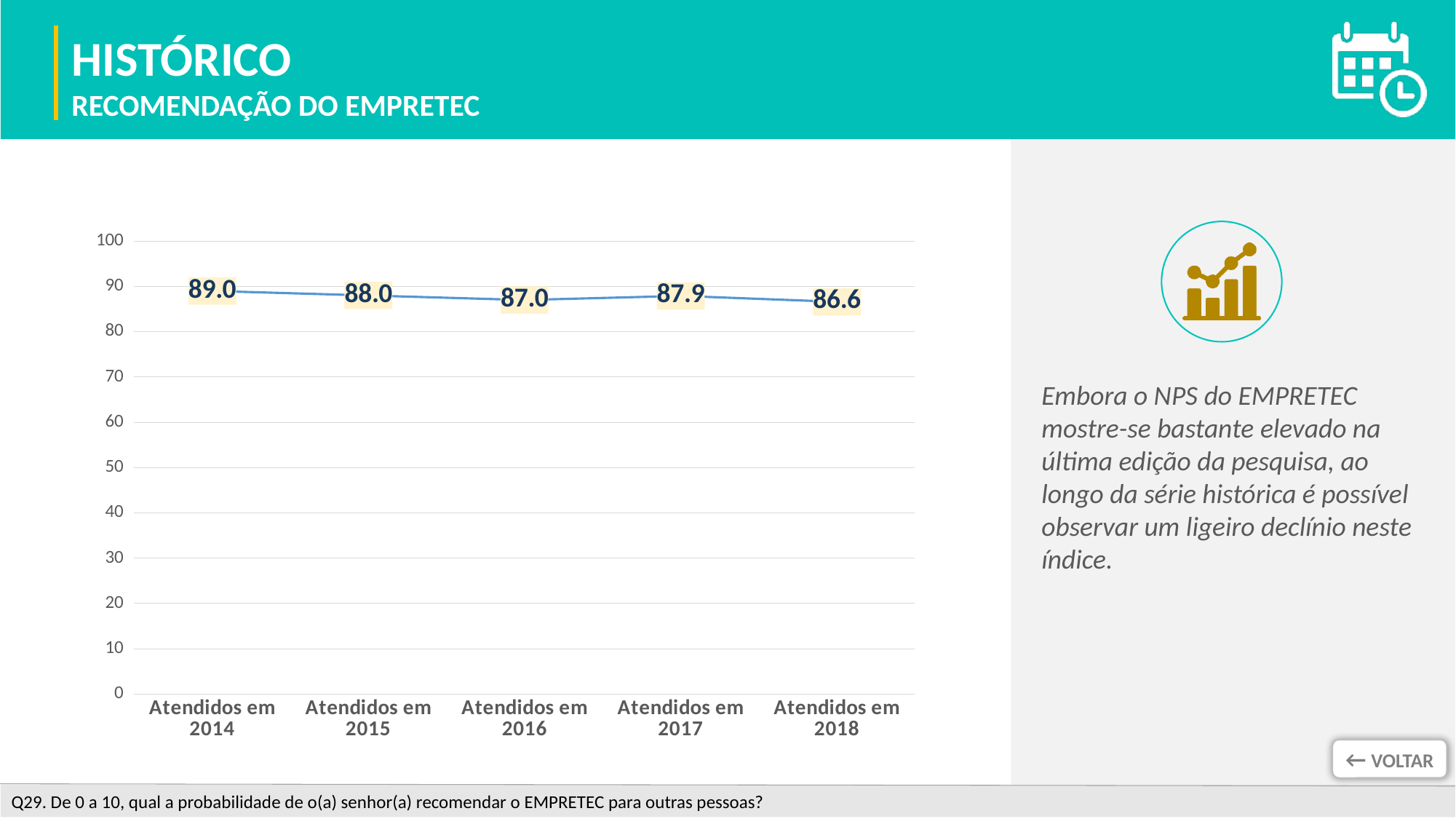
Do the values generally rise or fall from 2014 to 2018? fall What is the value for Atendidos em 2016? 87.0 Which is larger, the value for Atendidos em 2015 or Atendidos em 2017? Atendidos em 2015 What kind of chart is shown on the slide? line chart Which category has the lowest value? Atendidos em 2018 What is the value for Atendidos em 2018? 86.6 Which category has the highest value? Atendidos em 2014 How many categories are plotted on the chart? 5 Is the value for Atendidos em 2016 greater or less than 80? greater What is the difference between the values for Atendidos em 2014 and Atendidos em 2018? 2.4 What is the value for Atendidos em 2014? 89.0 What is the value for Atendidos em 2017? 87.9